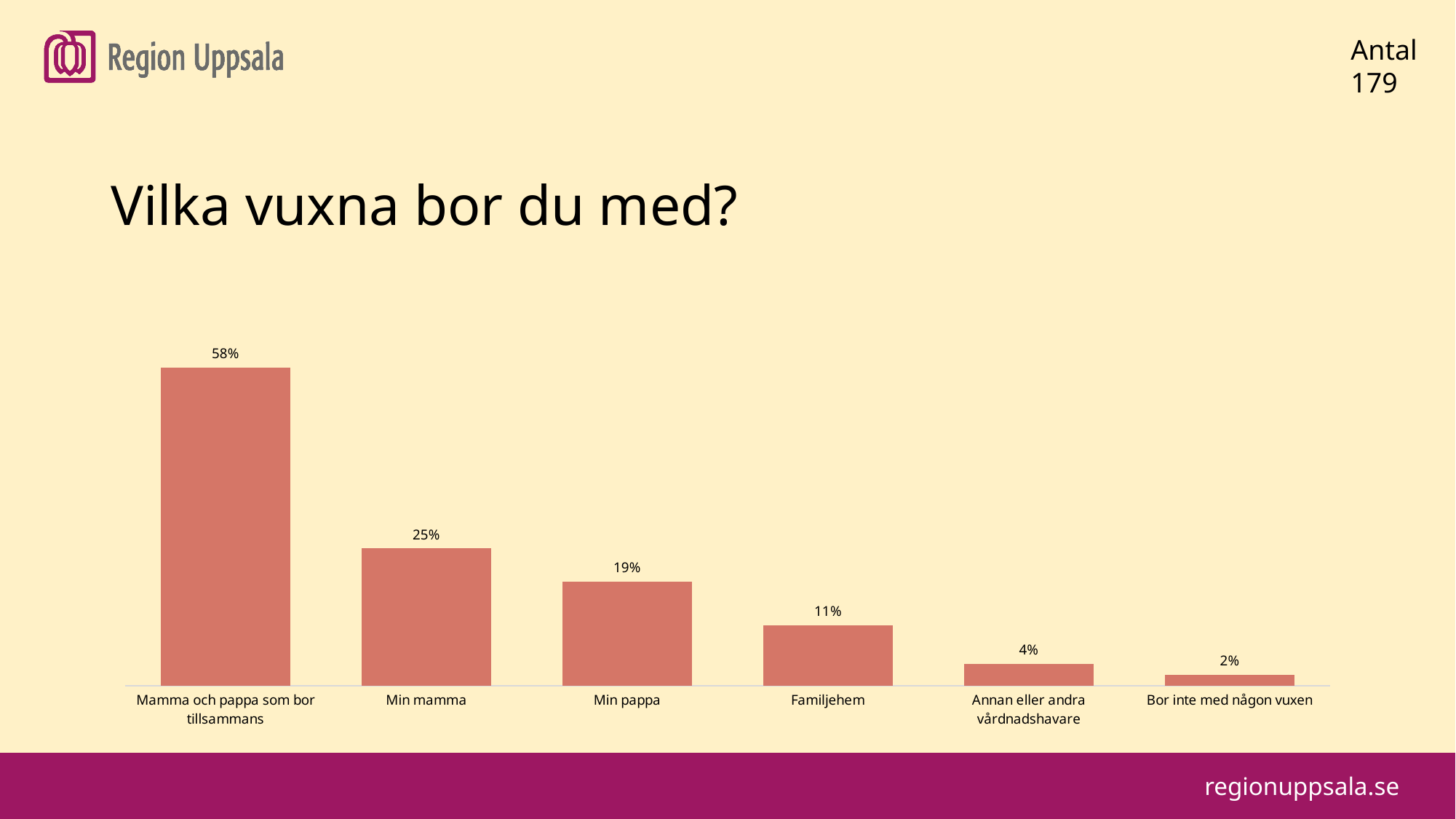
What is the value for "Min mamma"? 25% What is the difference between the values for "Mamma och pappa som bor tillsammans" and "Min mamma"? 33% Which category has the highest value? Mamma och pappa som bor tillsammans What is the difference between the values for "Min pappa" and "Familjehem"? 8% How many categories are shown in the chart? 6 Do the values rise or fall from left to right along the x axis? Fall What is the value for "Familjehem"? 11% What is the title of the chart on the slide? Vilka vuxna bor du med? What is the value for "Bor inte med någon vuxen"? 2% Which category has the lowest value? Bor inte med någon vuxen What kind of chart is shown on the slide? Bar chart Which is larger, the value for "Min pappa" or the value for "Annan eller andra vårdnadshavare"? Min pappa